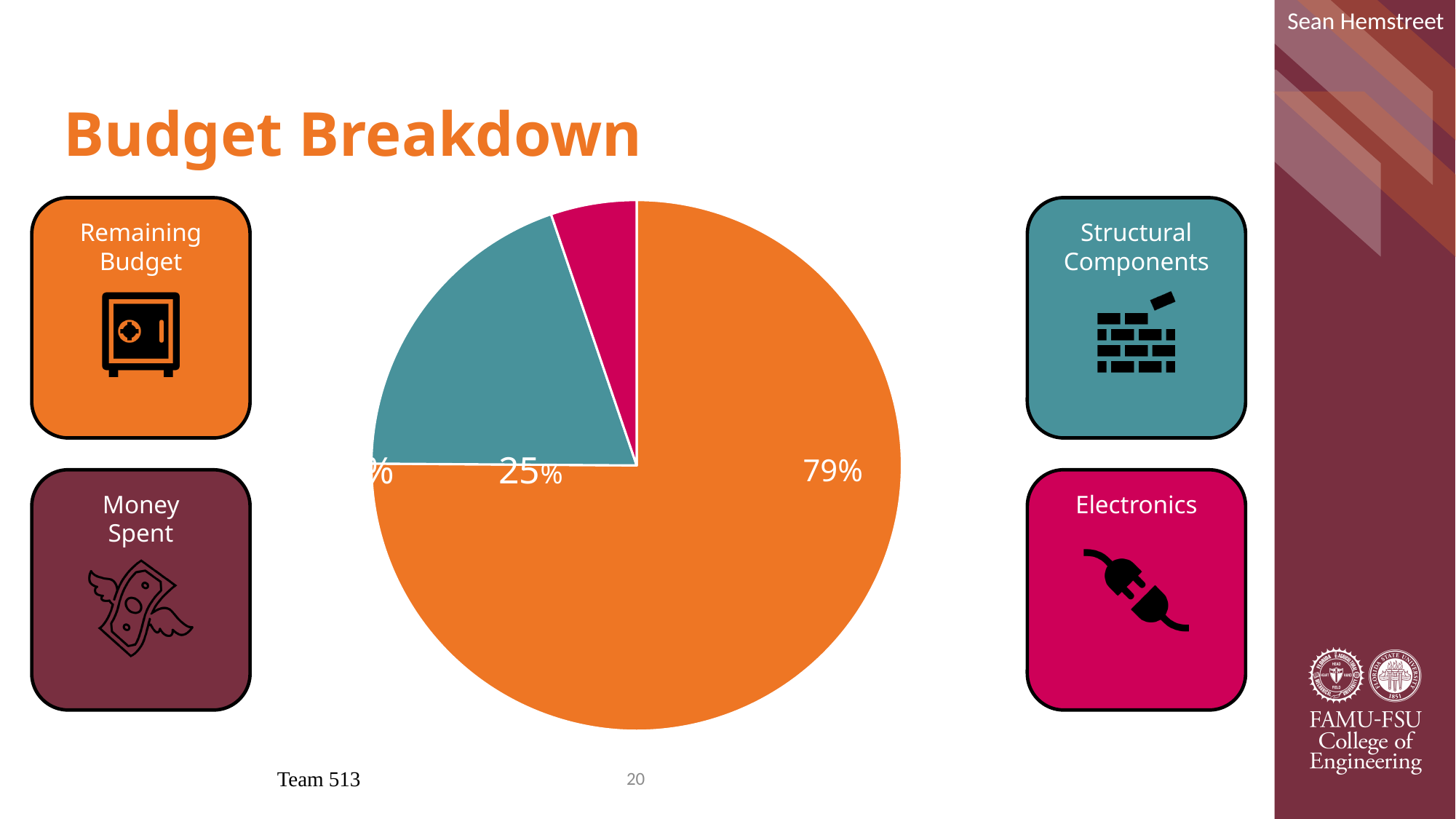
Which slice is larger, Structural Components or Electronics? Structural Components What is the title of the slide containing the pie chart? Budget Breakdown What colour is the Electronics slice of the pie? magenta Which category has the largest slice of the pie? Remaining Budget What kind of chart is shown on the slide? pie chart What share of the pie is labelled for the Remaining Budget (orange) slice? 79% Which slice is larger, Remaining Budget or Structural Components? Remaining Budget How many slices does the pie chart have? 3 Which category has the smallest slice of the pie? Electronics